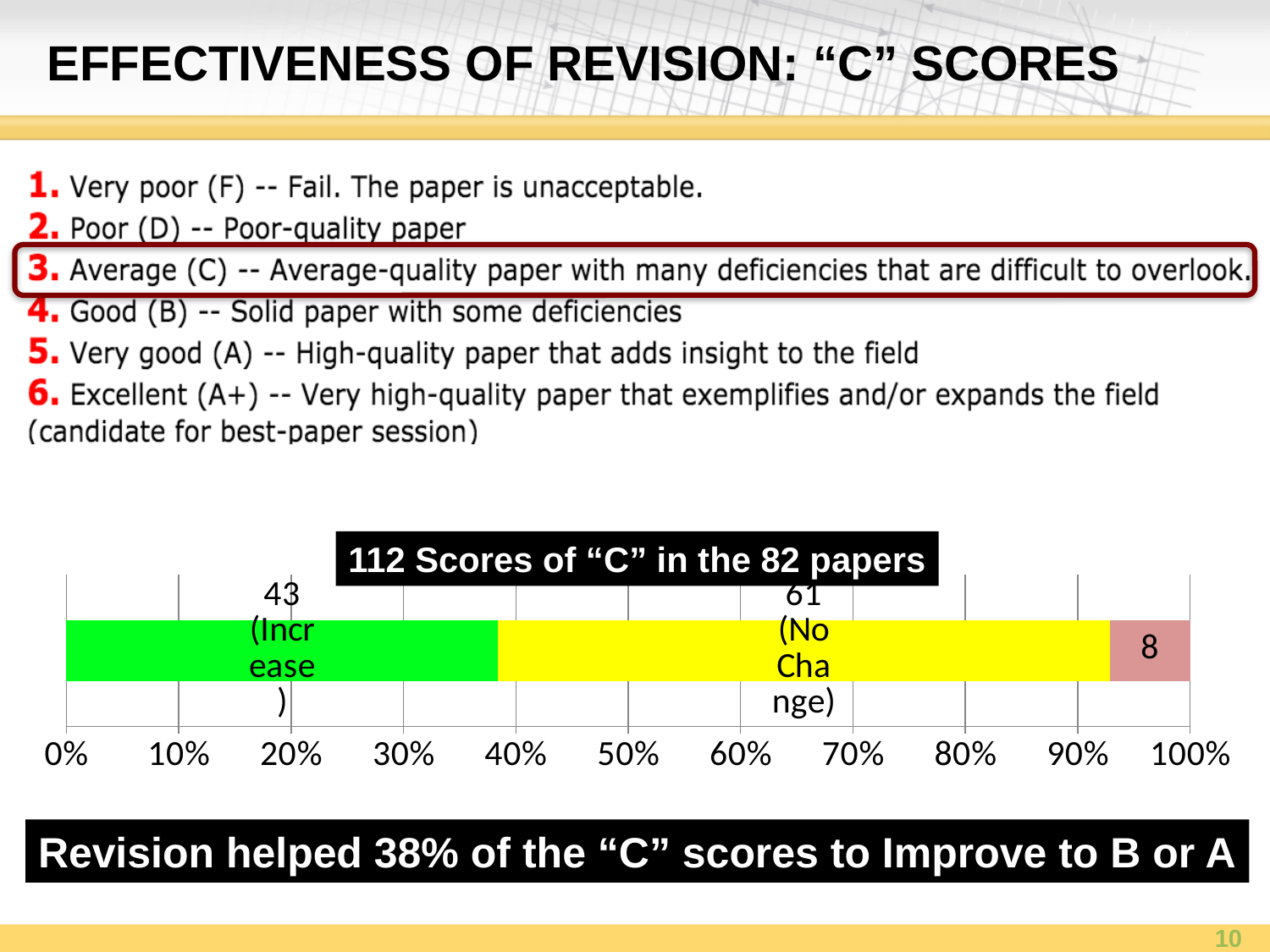
What is the title of the chart? 112 Scores of "C" in the 82 papers What value is printed on the pink segment at the right end of the bar? 8 What is the total of all three segments in the stacked bar? 112 What is the value of the green "Increase" segment in the chart? 43 Does the green "Increase" segment end at a share greater or less than 40%? less How many segments make up the stacked bar? 3 Which segment of the bar has the largest value? No Change What is the value of the yellow "No Change" segment in the chart? 61 What kind of chart is shown on the slide? stacked bar chart What is the difference between the "No Change" value and the "Increase" value? 18 Which is larger, the "Increase" segment or the "No Change" segment? No Change Which segment of the bar has the smallest value, the green, the yellow or the pink one? the pink one